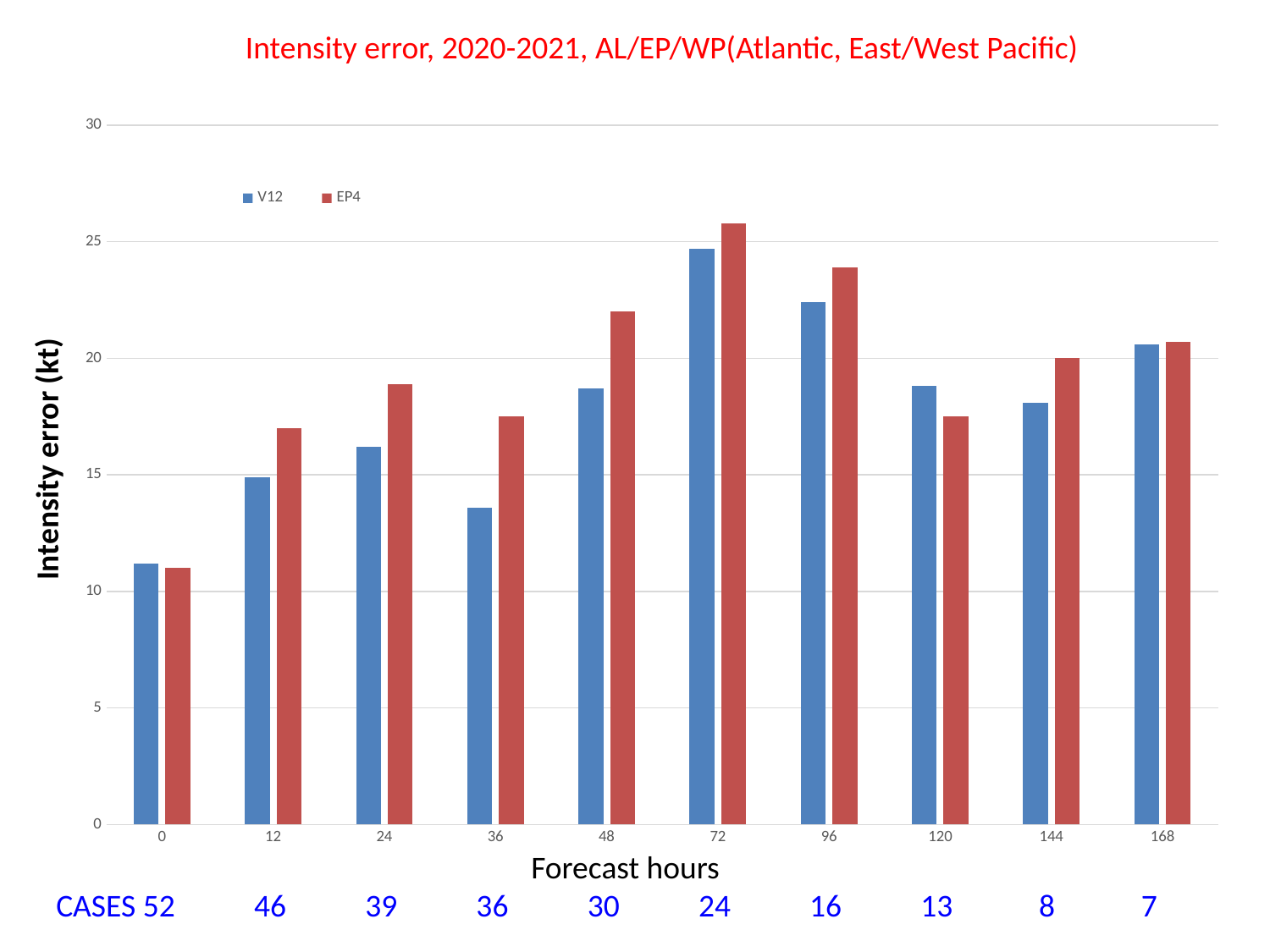
Is the V12 value at 72 forecast hours greater or less than 25? less What kind of chart is shown on the slide? bar chart At 48 forecast hours, which series has the larger intensity error, V12 or EP4? EP4 From 72 to 120 forecast hours, does the EP4 intensity error rise or fall? fall At which forecast hour is the EP4 intensity error lowest? 0 At which forecast hour is the V12 intensity error highest? 72 Is the V12 value at 36 forecast hours greater or less than 15? less At 120 forecast hours, which series has the larger intensity error, V12 or EP4? V12 What is the label on the y axis of the chart? Intensity error (kt) How many forecast-hour categories are plotted on the x axis? 10 Is the EP4 value at 48 forecast hours greater or less than 20? greater How many series does the legend list? 2